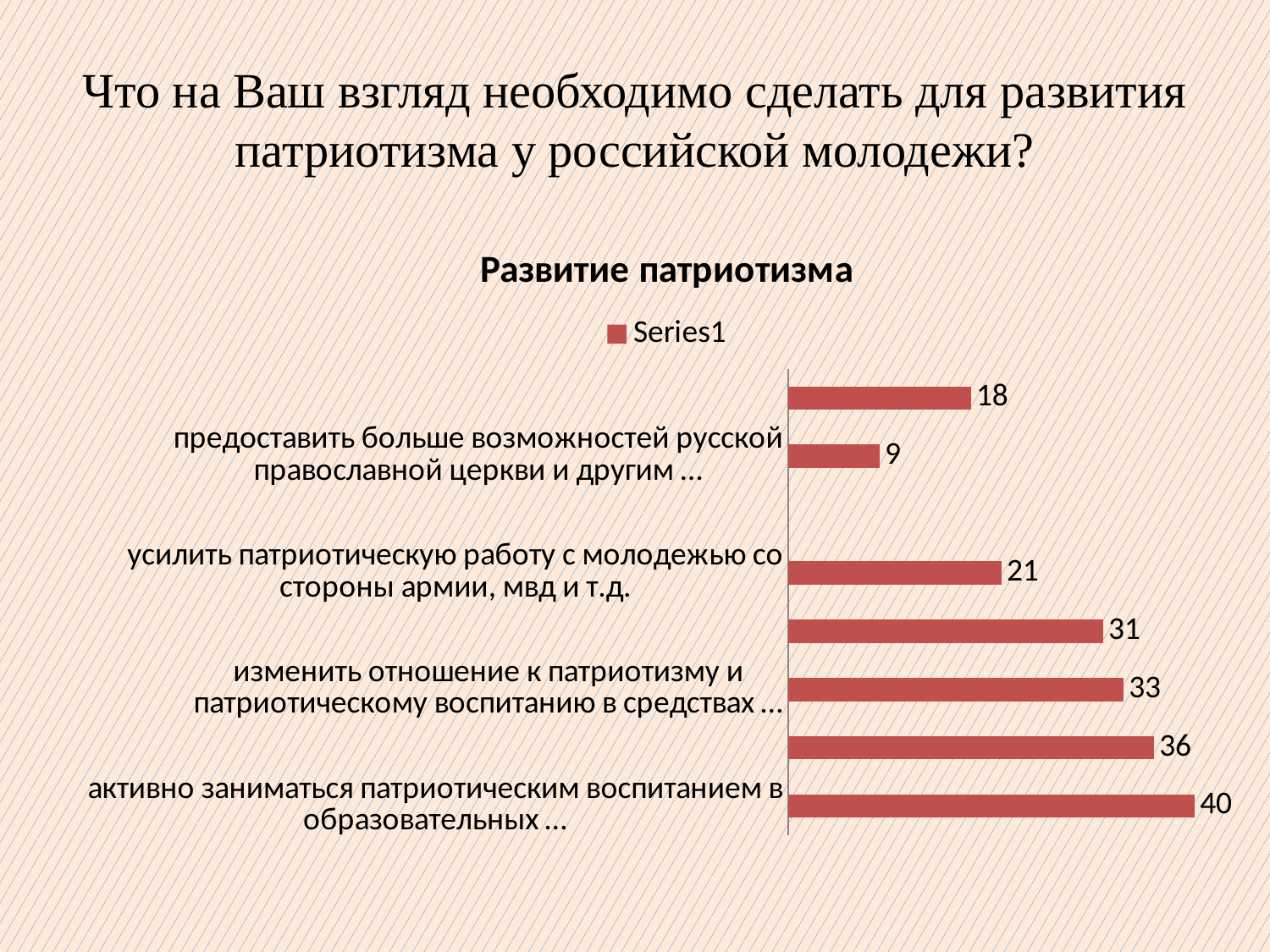
What is the difference between the value for "изменить отношение к патриотизму и патриотическому воспитанию в средствах …" and the value for "предоставить больше возможностей русской православной церкви и другим …"? 24 How many series does the legend list? 1 What is the value for the category "активно заниматься патриотическим воспитанием в образовательных …"? 40 What is the value for "усилить патриотическую работу с молодежью со стороны армии, мвд и т.д."? 21 What kind of chart is shown on the slide? bar chart What is the value for "изменить отношение к патриотизму и патриотическому воспитанию в средствах …"? 33 Which is larger: the value for "усилить патриотическую работу с молодежью со стороны армии, мвд и т.д." or the value for "предоставить больше возможностей русской православной церкви и другим …"? усилить патриотическую работу с молодежью со стороны армии, мвд и т.д. What is the difference between the value for "активно заниматься патриотическим воспитанием в образовательных …" and the value for "усилить патриотическую работу с молодежью со стороны армии, мвд и т.д."? 19 What is the smallest value shown on the chart? 9 What is the title of the chart? Развитие патриотизма Which category has the highest value on the chart? активно заниматься патриотическим воспитанием в образовательных … What is the value for "предоставить больше возможностей русской православной церкви и другим …"? 9